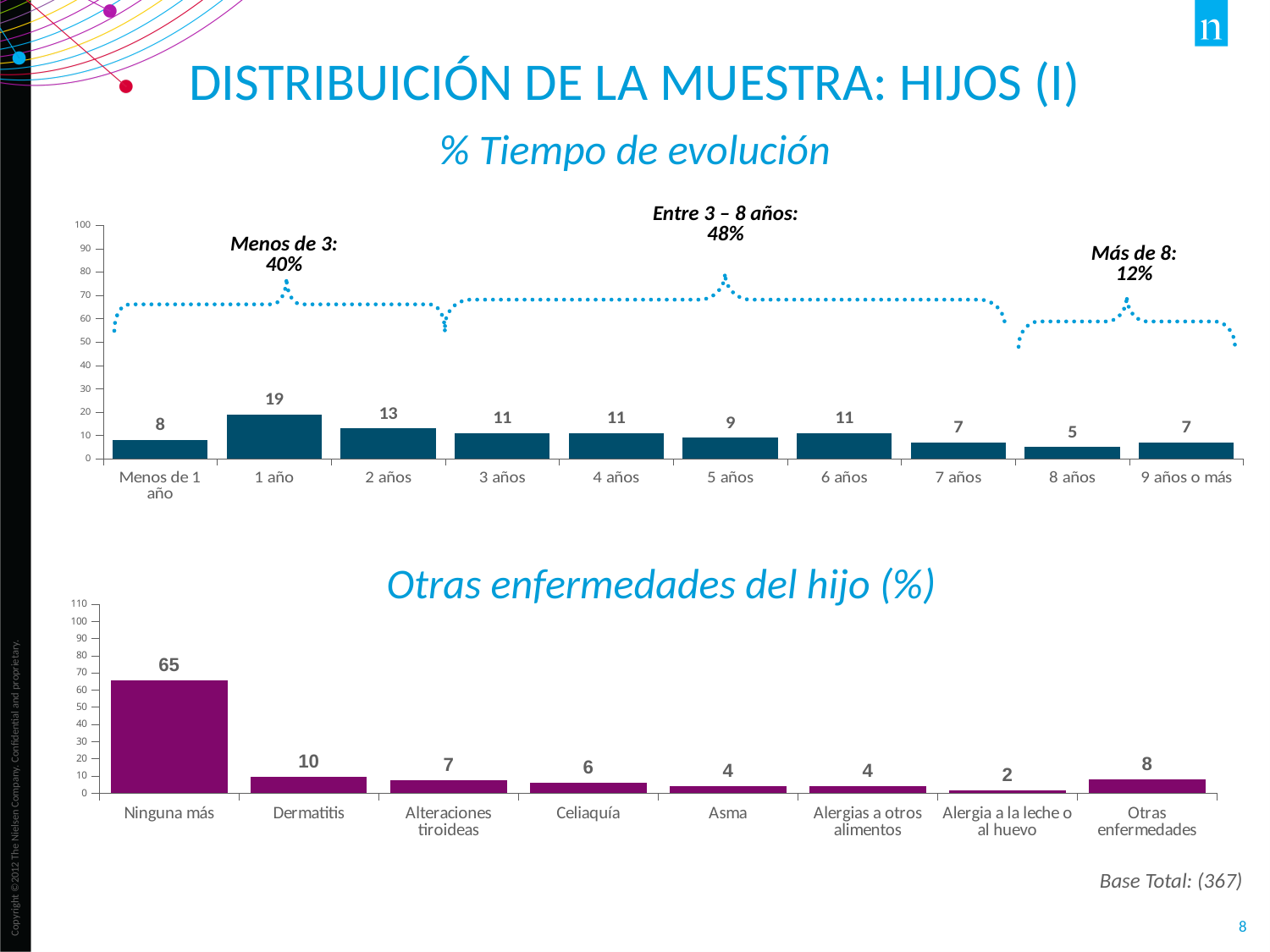
In the '% Tiempo de evolución' chart, what is the value for '1 año'? 19 In the '% Tiempo de evolución' chart, how many categories are shown on the x axis? 10 In the '% Tiempo de evolución' chart, which category has the lowest value? 8 años In the 'Otras enfermedades del hijo (%)' chart, which category has the lowest value? Alergia a la leche o al huevo In the 'Otras enfermedades del hijo (%)' chart, how many categories are shown? 8 In the '% Tiempo de evolución' chart, what percentage is given for 'Entre 3 – 8 años'? 48% What type of chart is the 'Otras enfermedades del hijo (%)' chart? Bar chart In the 'Otras enfermedades del hijo (%)' chart, what is the difference between 'Ninguna más' and 'Dermatitis'? 55 In the '% Tiempo de evolución' chart, what is the difference between the values for '1 año' and '2 años'? 6 In the '% Tiempo de evolución' chart, which category has the highest value? 1 año In the 'Otras enfermedades del hijo (%)' chart, what is the value for 'Ninguna más'? 65 In the 'Otras enfermedades del hijo (%)' chart, which is larger: 'Dermatitis' or 'Otras enfermedades'? Dermatitis